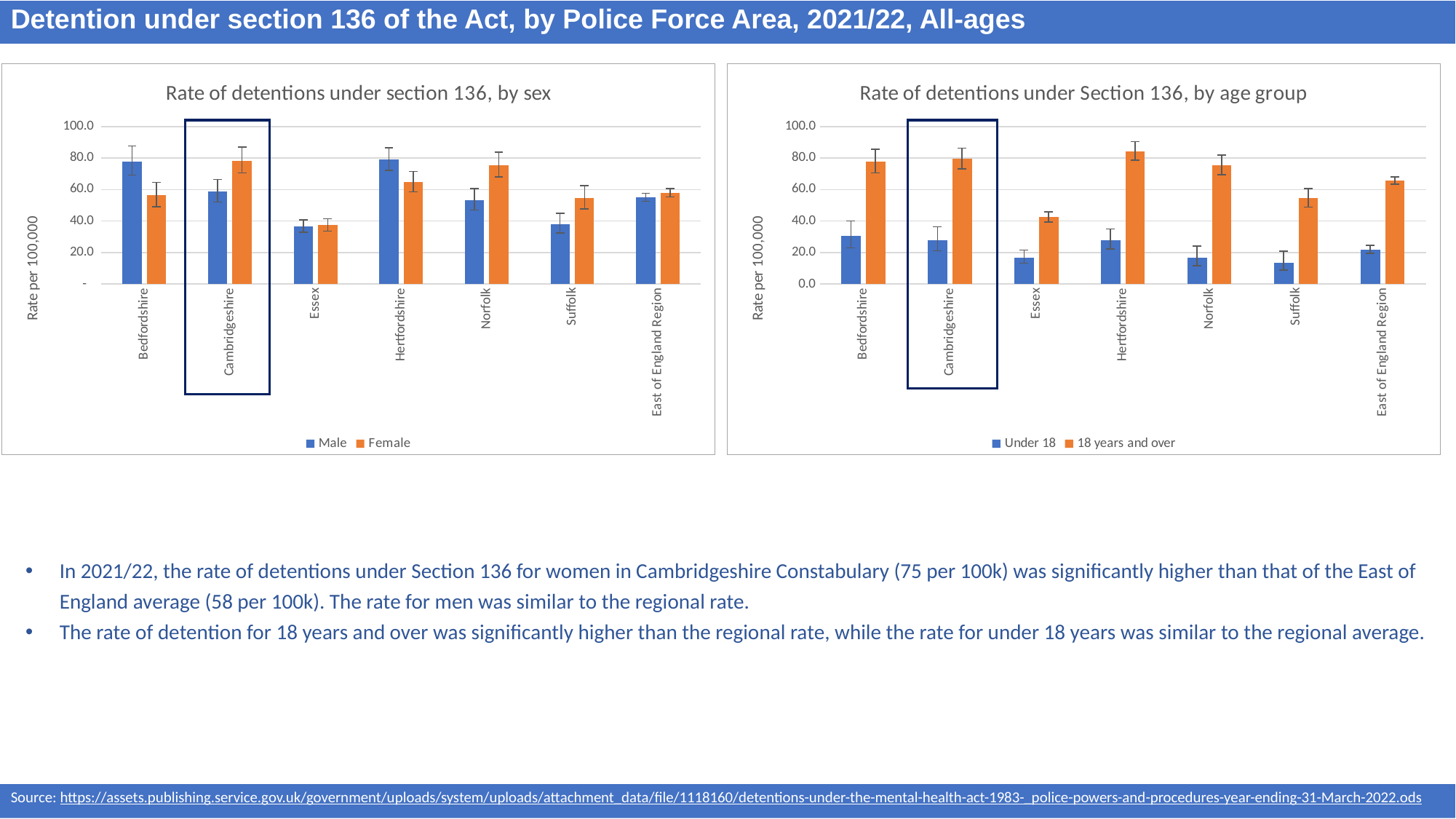
How many police force area categories are shown on the x axis of the right chart, 'Rate of detentions under Section 136, by age group'? 7 In the right chart, 'Rate of detentions under Section 136, by age group', which is larger for Hertfordshire, the Under 18 rate or the 18 years and over rate? 18 years and over In the right chart, 'Rate of detentions under Section 136, by age group', which police force area has the lowest rate for 18 years and over? Essex In the left chart, 'Rate of detentions under section 136, by sex', is the Male value for Essex greater or less than 40? less How many series does the legend of the left chart, 'Rate of detentions under section 136, by sex', list? 2 In the left chart, 'Rate of detentions under section 136, by sex', which police force area has the lowest Female rate? Essex In the right chart, 'Rate of detentions under Section 136, by age group', is the Under 18 value for Suffolk greater or less than 20? less In the left chart, 'Rate of detentions under section 136, by sex', which is larger for Cambridgeshire, the Male or the Female rate? Female In the left chart, 'Rate of detentions under section 136, by sex', is the Male value for Bedfordshire greater or less than 60? greater What are the two series named in the legend of the right chart, 'Rate of detentions under Section 136, by age group'? Under 18 and 18 years and over What is the y-axis label of the left chart, 'Rate of detentions under section 136, by sex'? Rate per 100,000 What kind of chart is the left chart, 'Rate of detentions under section 136, by sex'? bar chart